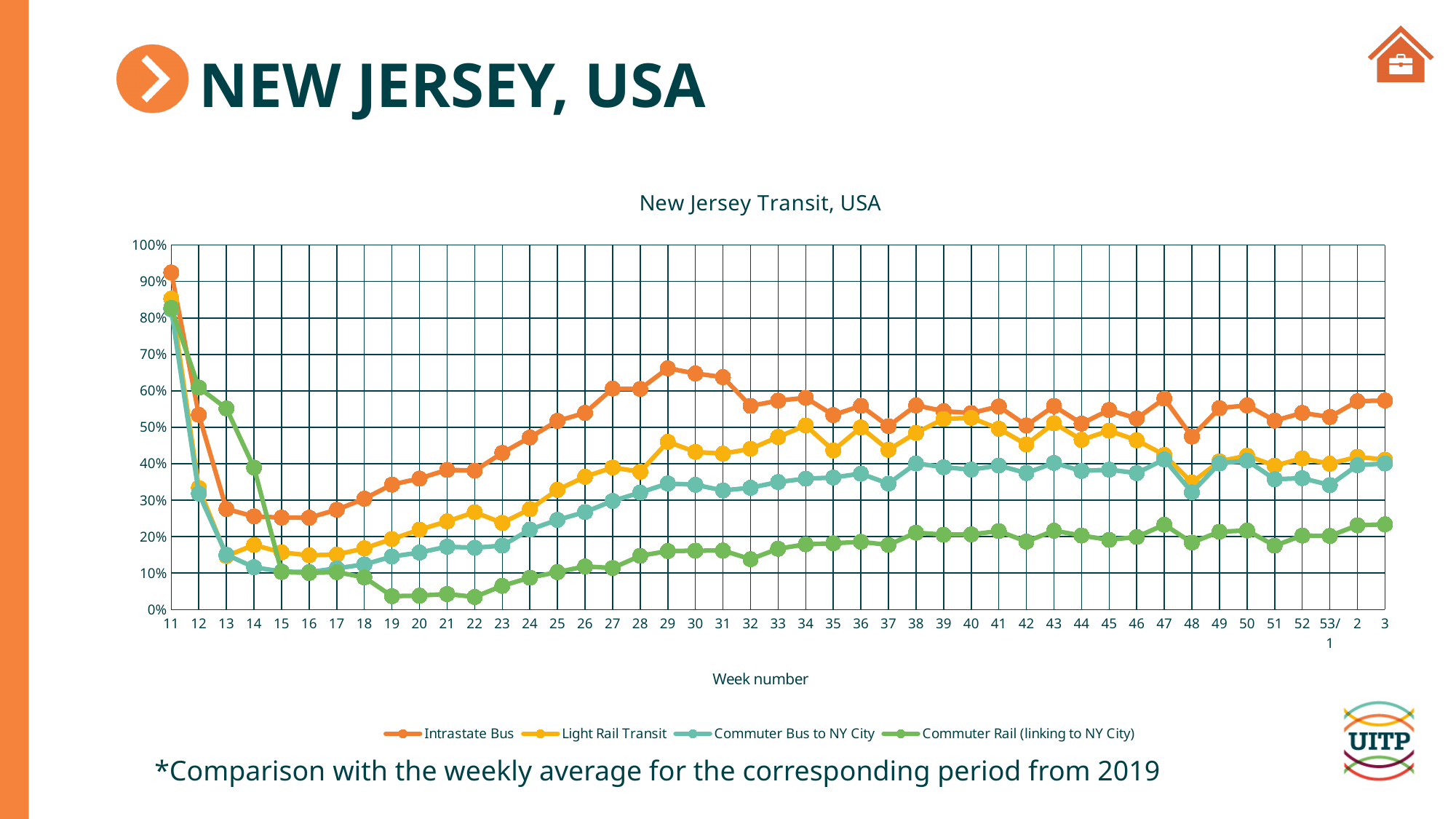
Is the value for Light Rail Transit at week 16 greater or less than 20%? less How many series does the legend list? 4 What is the title of the chart? New Jersey Transit, USA Does the Commuter Rail (linking to NY City) line rise or fall from week 15 to week 3? rise Is the value for Intrastate Bus at week 29 greater or less than 60%? greater Is the value for Commuter Rail (linking to NY City) at week 22 greater or less than 10%? less At week 40, which is larger: Intrastate Bus or Commuter Rail (linking to NY City)? Intrastate Bus At week 13, which is larger: Commuter Rail (linking to NY City) or Intrastate Bus? Commuter Rail (linking to NY City) What is the label of the x axis? Week number Which series has the lowest value at week 30? Commuter Rail (linking to NY City) Which series has the highest value at week 3? Intrastate Bus What kind of chart is shown on the slide? line chart